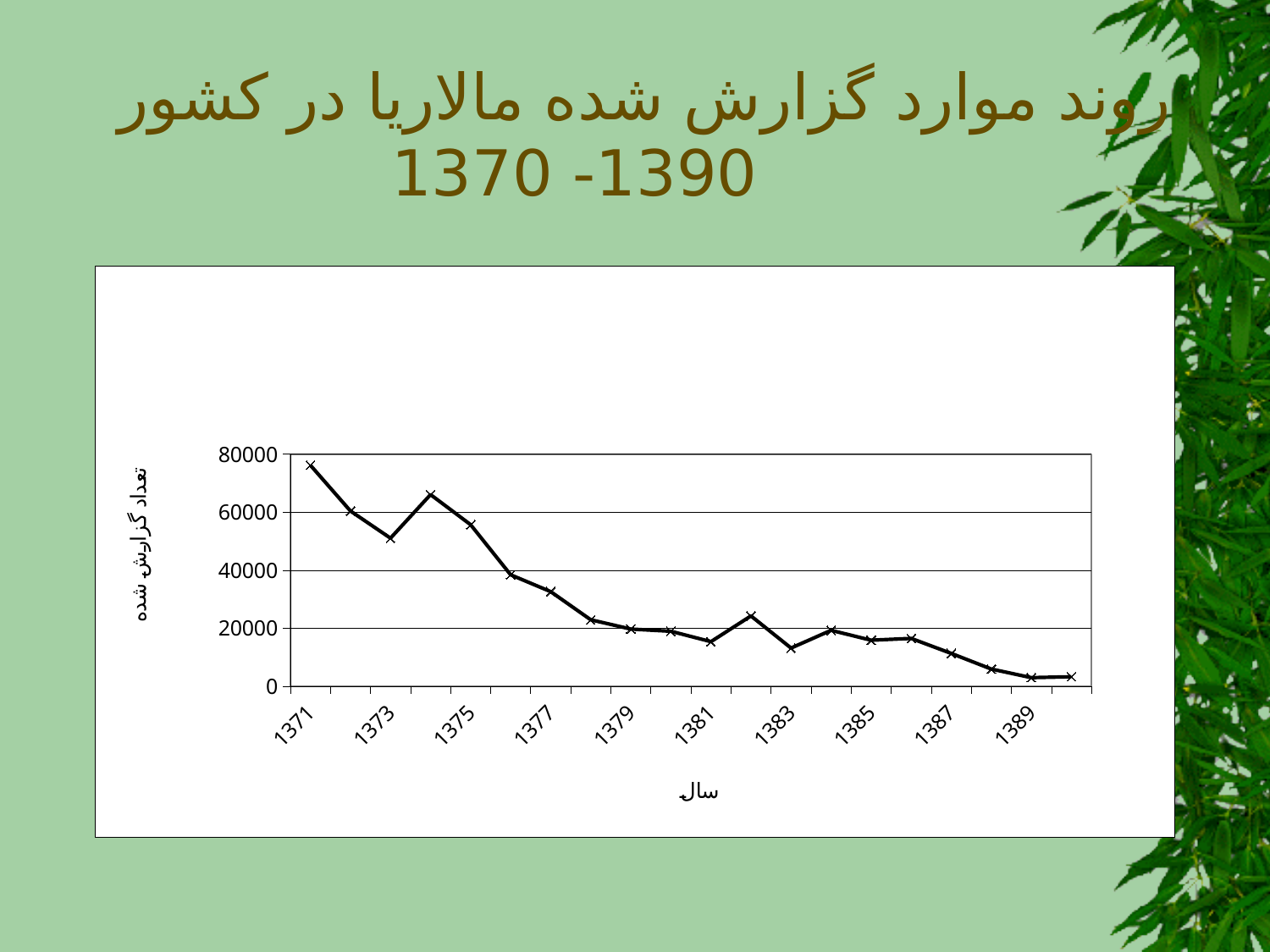
What kind of chart is shown on the slide? line chart Is the value for 1381 greater or less than 20000? less Is the value for 1371 greater or less than 60000? greater How many data points are plotted on the line? 20 Is the value for 1373 greater or less than 40000? greater What is the label on the x axis of the chart? سال Which year has the highest number of reported cases? 1371 Which is larger, the value for 1374 or the value for 1376? 1374 Do the reported malaria cases generally rise or fall from 1371 to 1390? fall Which is larger, the value for 1371 or the value for 1373? 1371